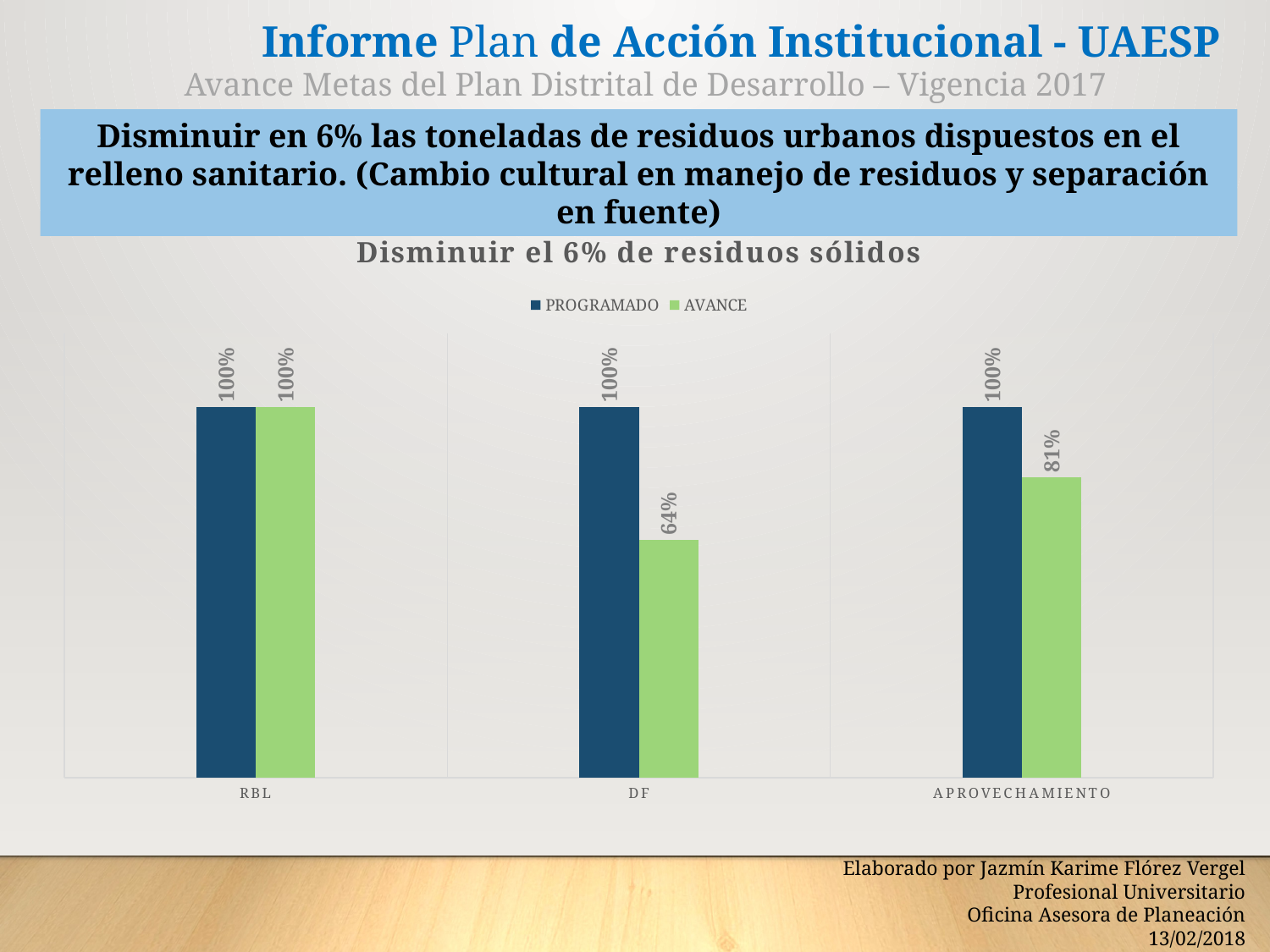
What is the AVANCE value for APROVECHAMIENTO? 81% What is the AVANCE value for DF? 64% What is the PROGRAMADO value for RBL? 100% How many categories are shown on the x axis? 3 What kind of chart is shown on the slide? Bar chart Which category has the lowest AVANCE value? DF What is the difference between the PROGRAMADO and AVANCE values for DF? 36% What is the difference between the AVANCE values for APROVECHAMIENTO and DF? 17% How many series does the legend list? 2 Which category has the highest AVANCE value? RBL What is the AVANCE value for RBL? 100% Which is larger, the AVANCE value for DF or the AVANCE value for APROVECHAMIENTO? APROVECHAMIENTO